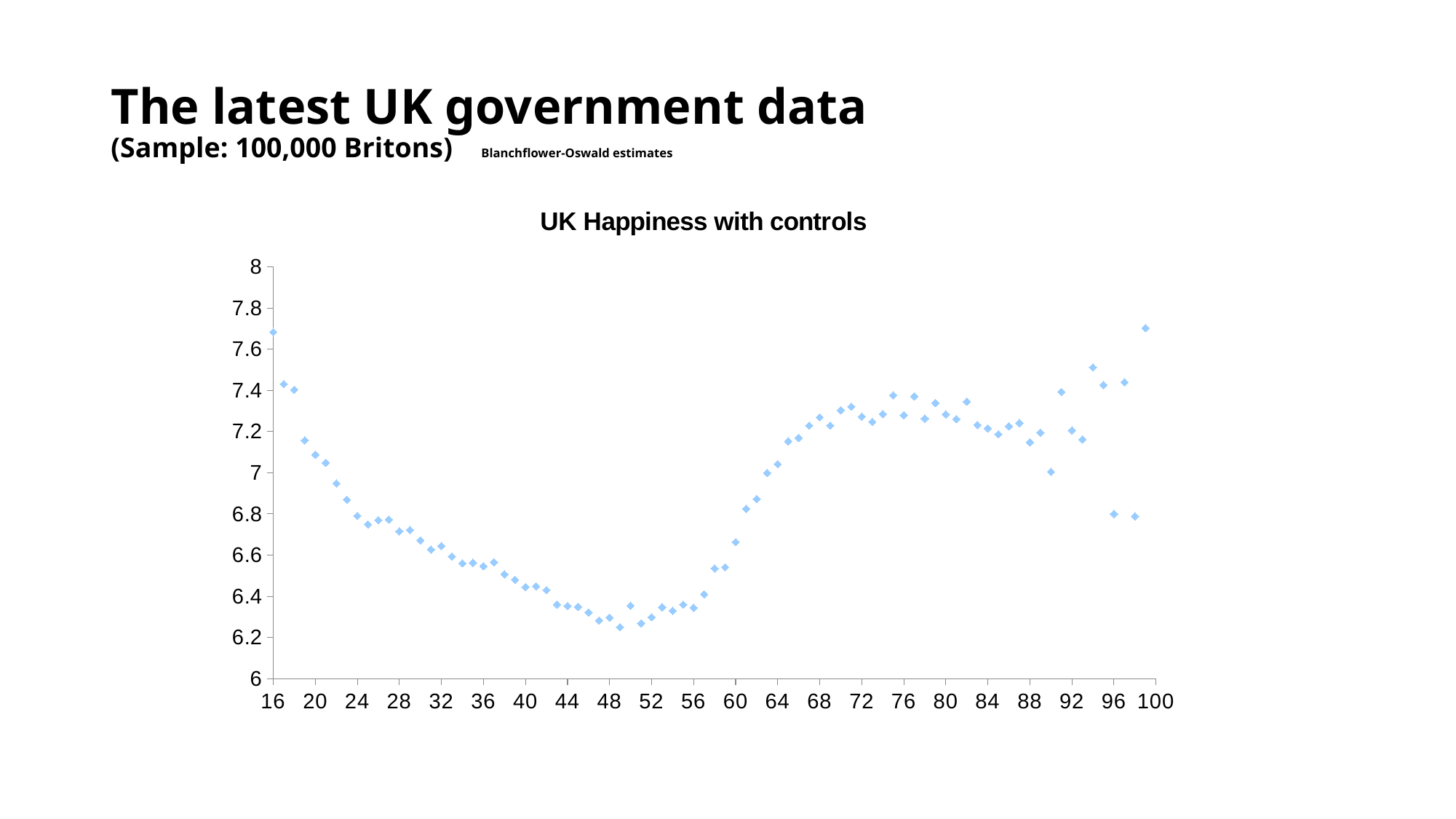
Is the value at age 76 greater or less than 7.2? greater What is the lowest value shown on the chart's vertical axis? 6 Do the values rise or fall as age increases from 50 to 76? rise Is the value at age 49 greater or less than 6.4? less Is the value at age 96 greater or less than 7? less What is the title of the chart? UK Happiness with controls Which is larger, the value at age 16 or the value at age 48? age 16 What kind of chart is shown on the slide? scatter chart Do the values rise or fall as age increases from 16 to 48? fall